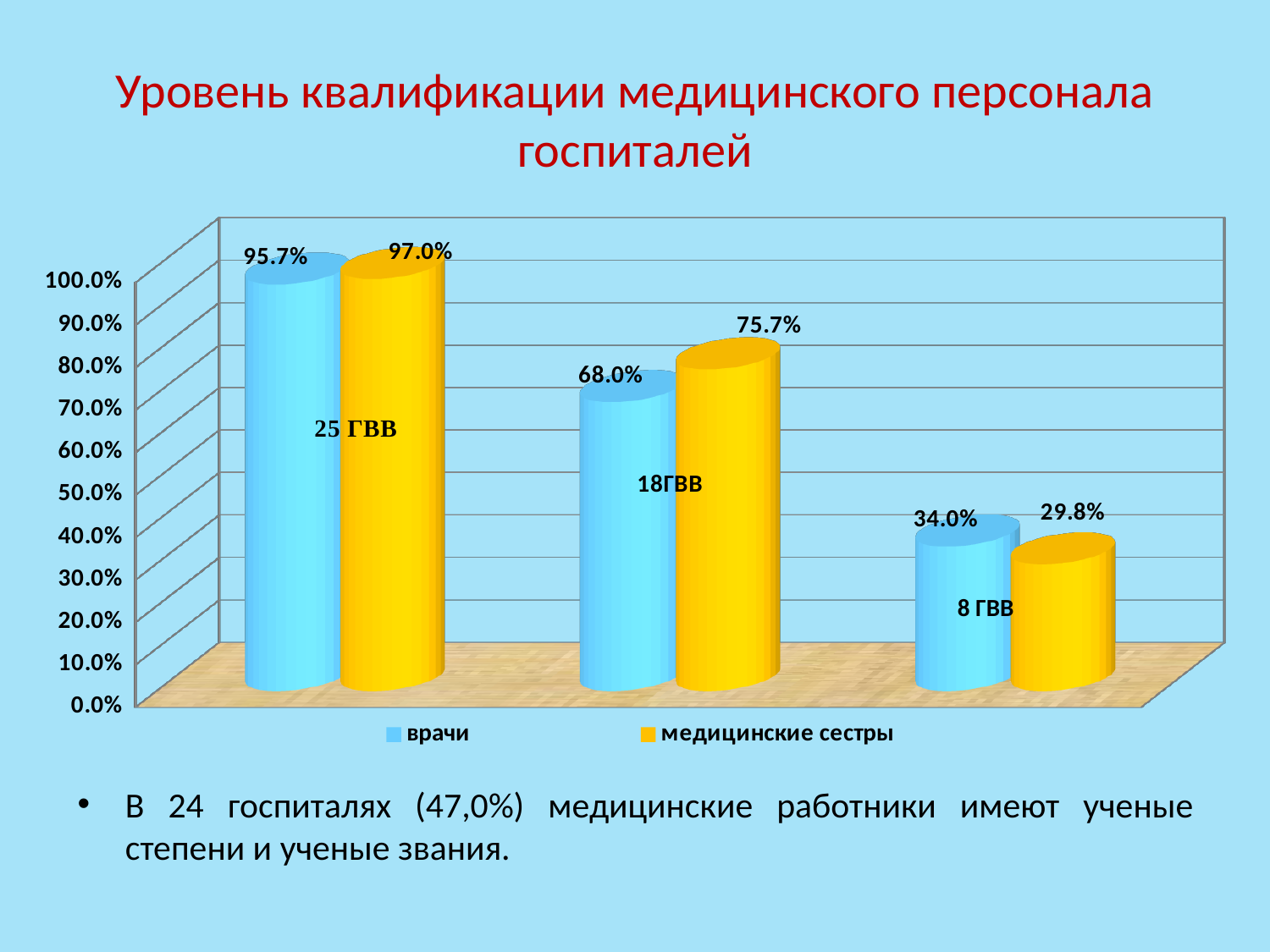
What is the value for врачи in the 8 ГВВ group? 34.0% How many groups of bars are shown in the chart? 3 How many series does the legend list? 2 Which group has the lowest value for врачи? 8 ГВВ What is the value for медицинские сестры in the 18ГВВ group? 75.7% In the 8 ГВВ group, which is larger: врачи or медицинские сестры? врачи What kind of chart is shown on the slide? bar chart Which colour represents медицинские сестры in the chart? yellow What is the value for врачи in the 25 ГВВ group? 95.7% What is the value for медицинские сестры in the 8 ГВВ group? 29.8% What is the difference between the медицинские сестры and врачи values in the 18ГВВ group? 7.7% Which group has the highest value for медицинские сестры? 25 ГВВ